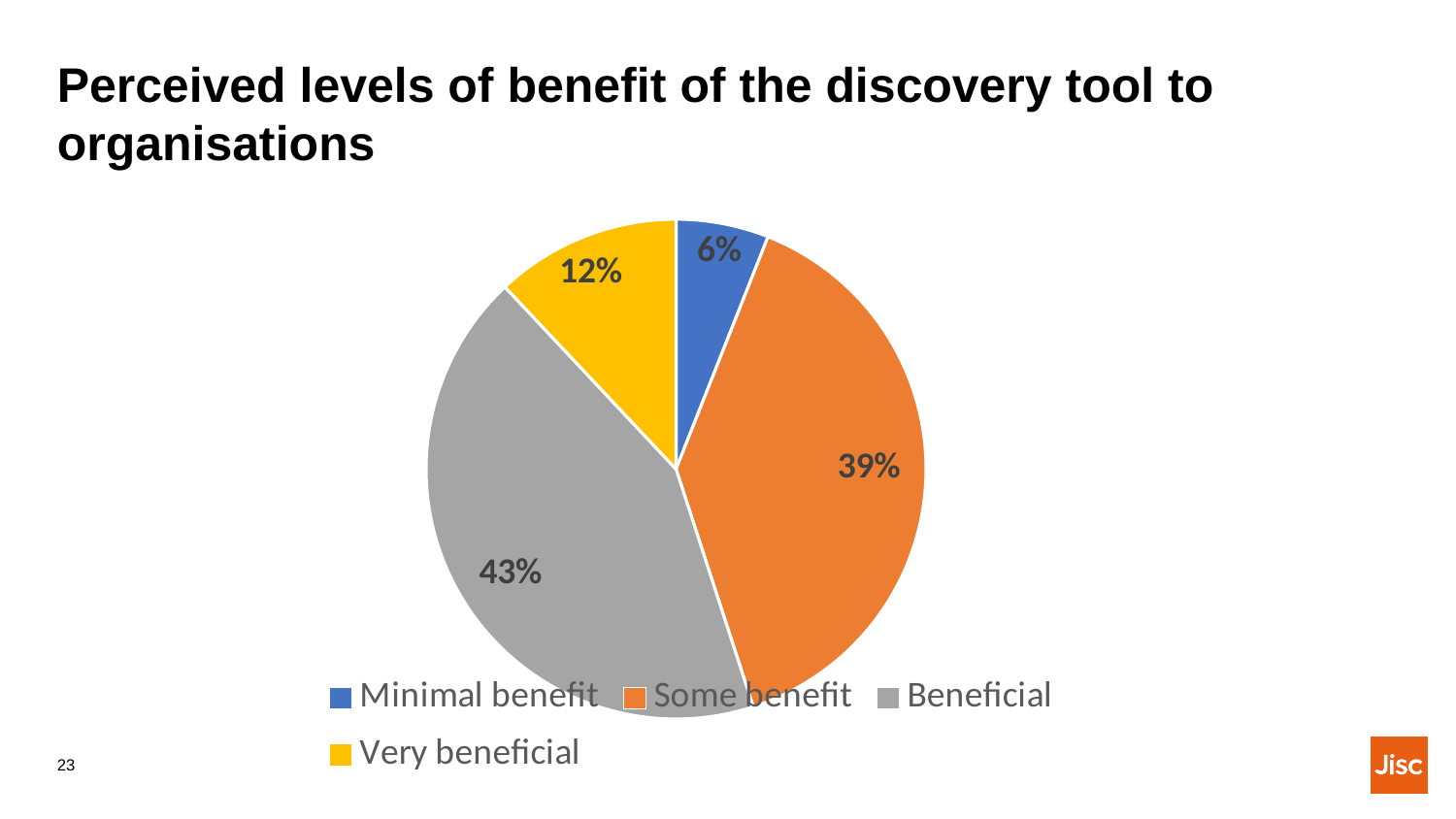
What percentage is shown for 'Very beneficial'? 12% What is the difference in percentage points between 'Beneficial' and 'Some benefit'? 4 Which category has the smallest share of the pie? Minimal benefit What percentage is shown for 'Some benefit'? 39% Which is larger, the share for 'Very beneficial' or the share for 'Minimal benefit'? Very beneficial What percentage is shown for 'Minimal benefit'? 6% Which category has the largest share of the pie? Beneficial What percentage of respondents said the discovery tool was 'Beneficial'? 43% What is the title of the slide containing the chart? Perceived levels of benefit of the discovery tool to organisations What colour is the 'Some benefit' slice? orange How many categories does the pie chart have? 4 What kind of chart is shown on the slide? pie chart